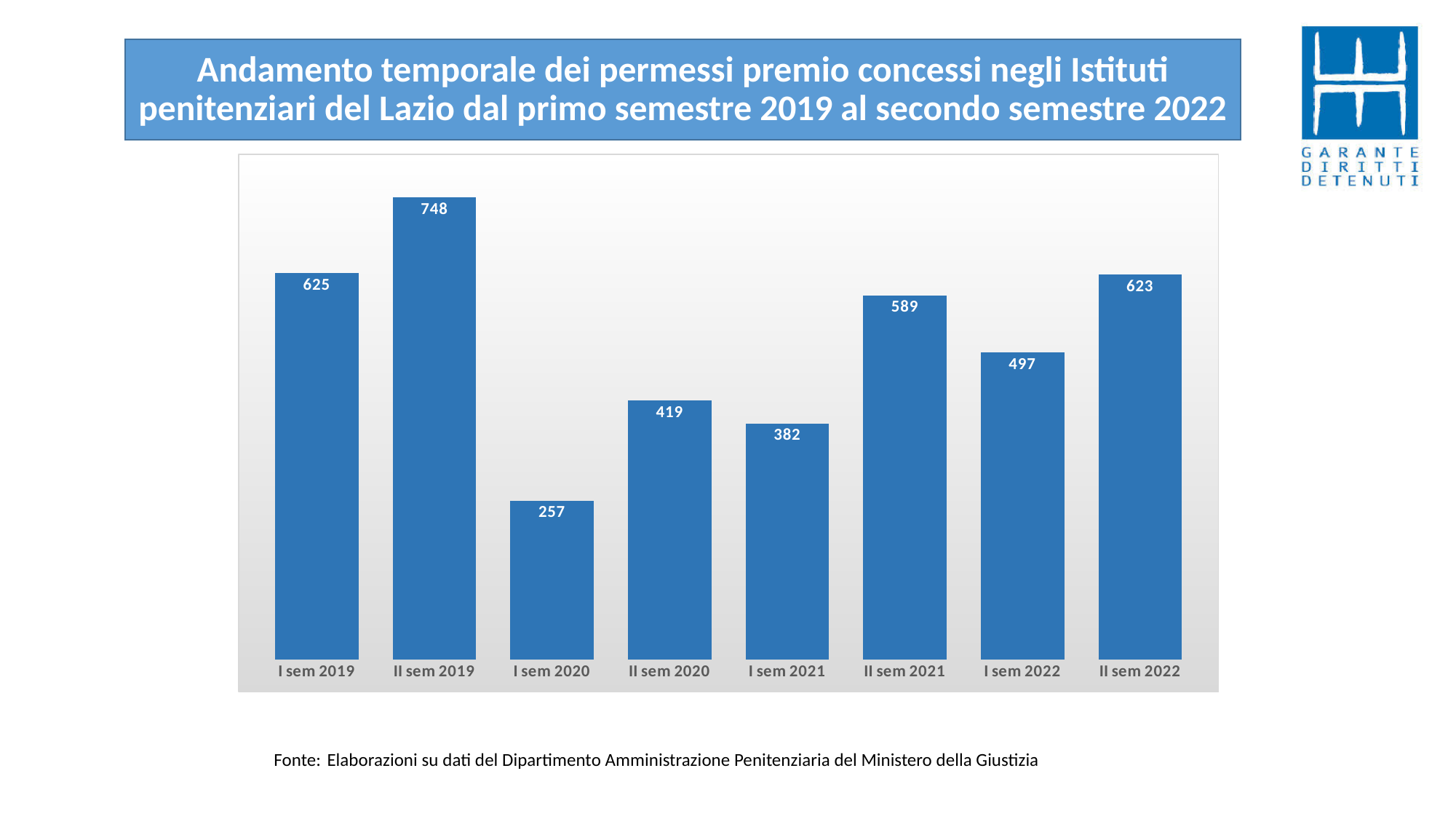
What kind of chart is shown on the slide? Bar chart What is the value for I sem 2022? 497 What is the difference between the values for II sem 2021 and I sem 2021? 207 Which semester has the highest value? II sem 2019 Do the values rise or fall from I sem 2021 to II sem 2021? Rise What is the value for I sem 2020? 257 Which semester has the lowest value? I sem 2020 What is the value for II sem 2019? 748 Which is larger, the value for I sem 2019 or the value for II sem 2022? I sem 2019 Which is larger, the value for II sem 2020 or the value for I sem 2021? II sem 2020 What is the difference between the values for II sem 2019 and I sem 2020? 491 How many semesters are shown on the x axis? 8